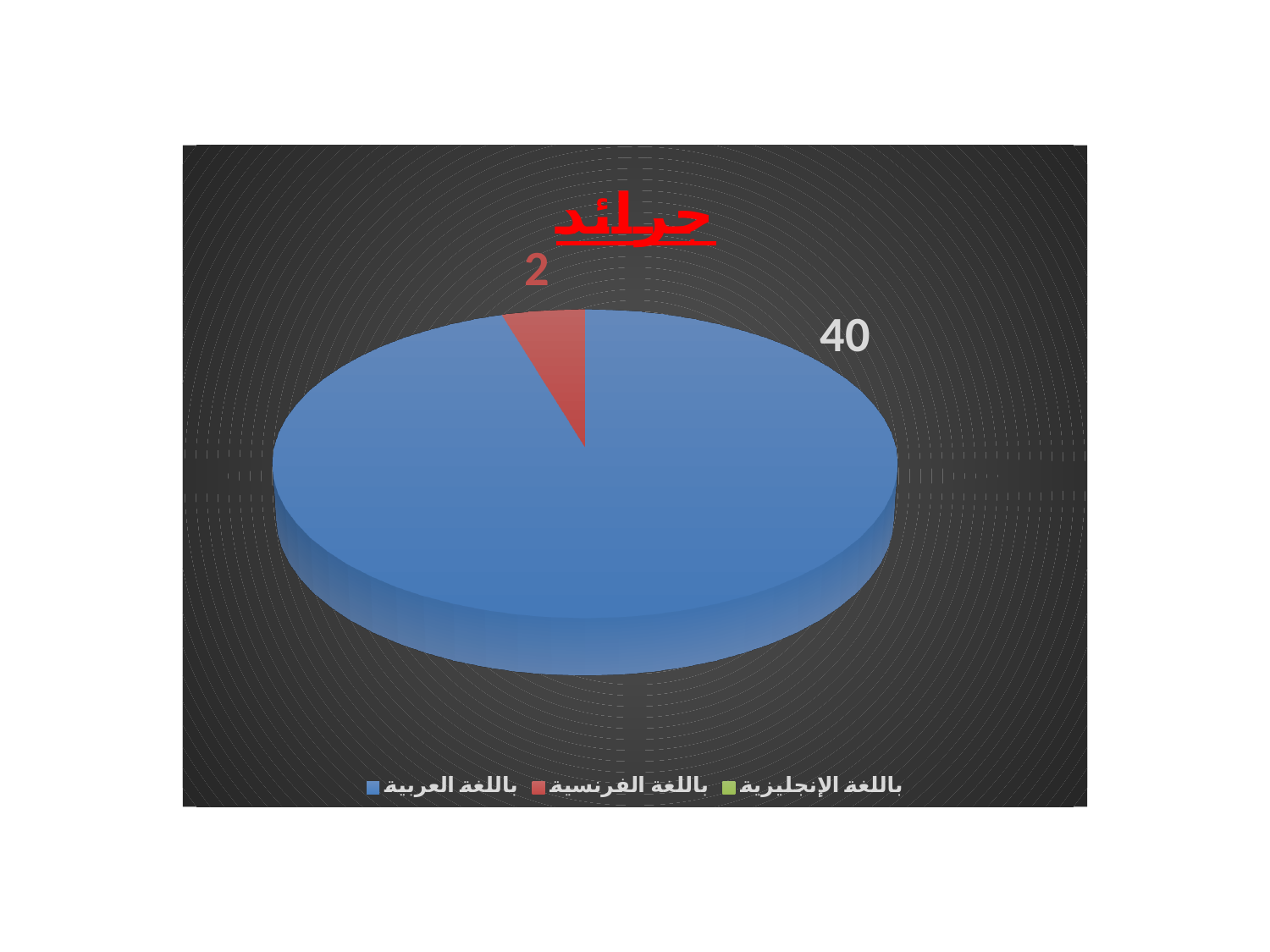
What is the difference between the values for باللغة العربية and باللغة الفرنسية? 38 What is the title of the chart? جرائد Which category has the largest slice of the pie? باللغة العربية Which is larger, the value for باللغة العربية or the value for باللغة الفرنسية? باللغة العربية What is the value for باللغة العربية? 40 How many categories does the legend list? 3 What is the value for باللغة الفرنسية? 2 What colour is the slice for باللغة الفرنسية? red What type of chart is shown on the slide? pie chart